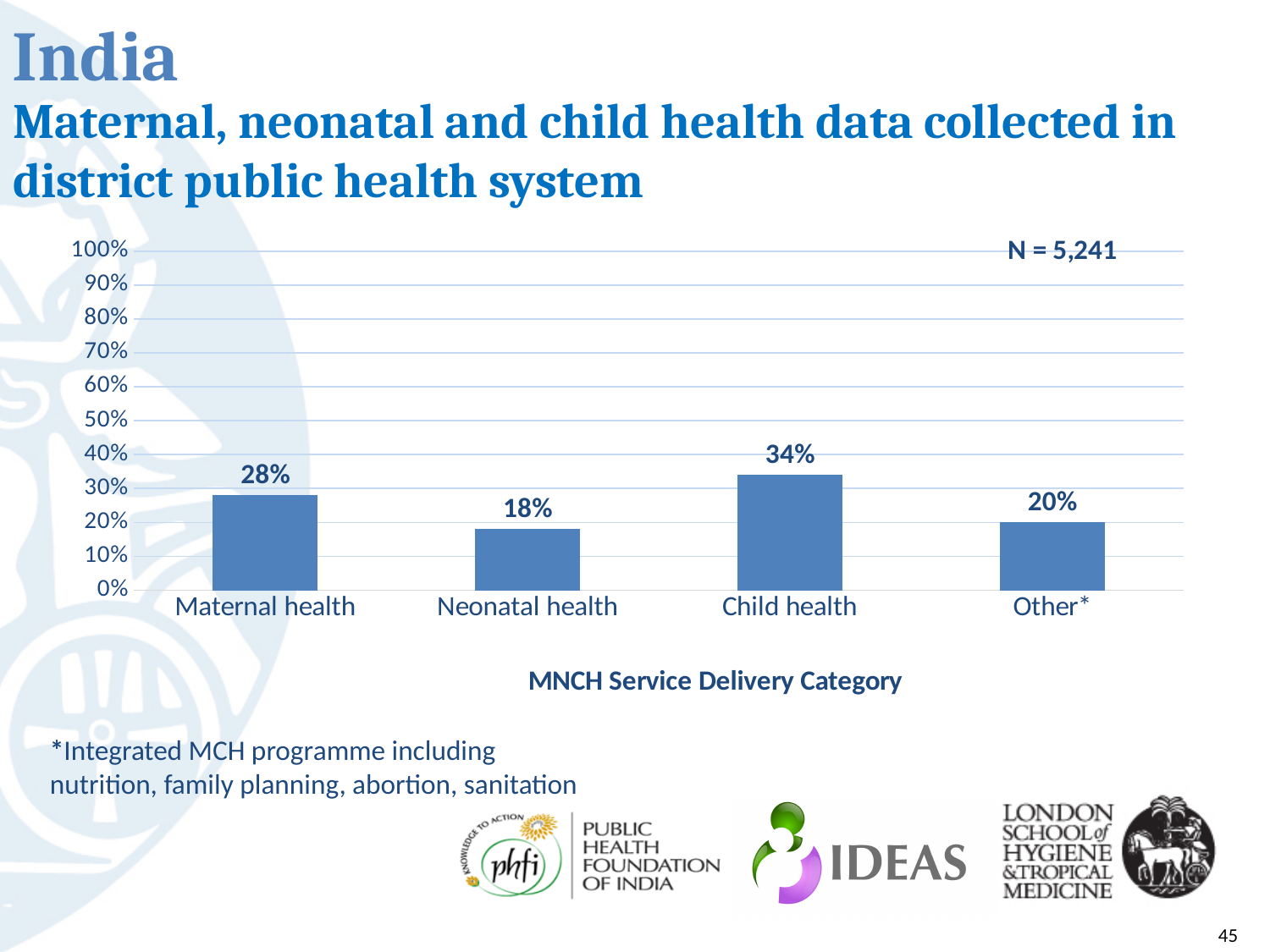
How many categories are shown on the x axis? 4 Which MNCH service delivery category has the highest percentage? Child health Which MNCH service delivery category has the lowest percentage? Neonatal health What kind of chart is shown on the slide? Bar chart Which is larger, the value for Maternal health or the value for Other*? Maternal health What percentage is shown for Other*? 20% What is the sample size (N) shown on the chart? N = 5,241 What percentage is shown for Child health? 34% Is the value for Child health greater or less than 30%? greater What percentage is shown for Neonatal health? 18% What percentage is shown for Maternal health? 28% What is the difference in percentage points between Child health and Neonatal health? 16%